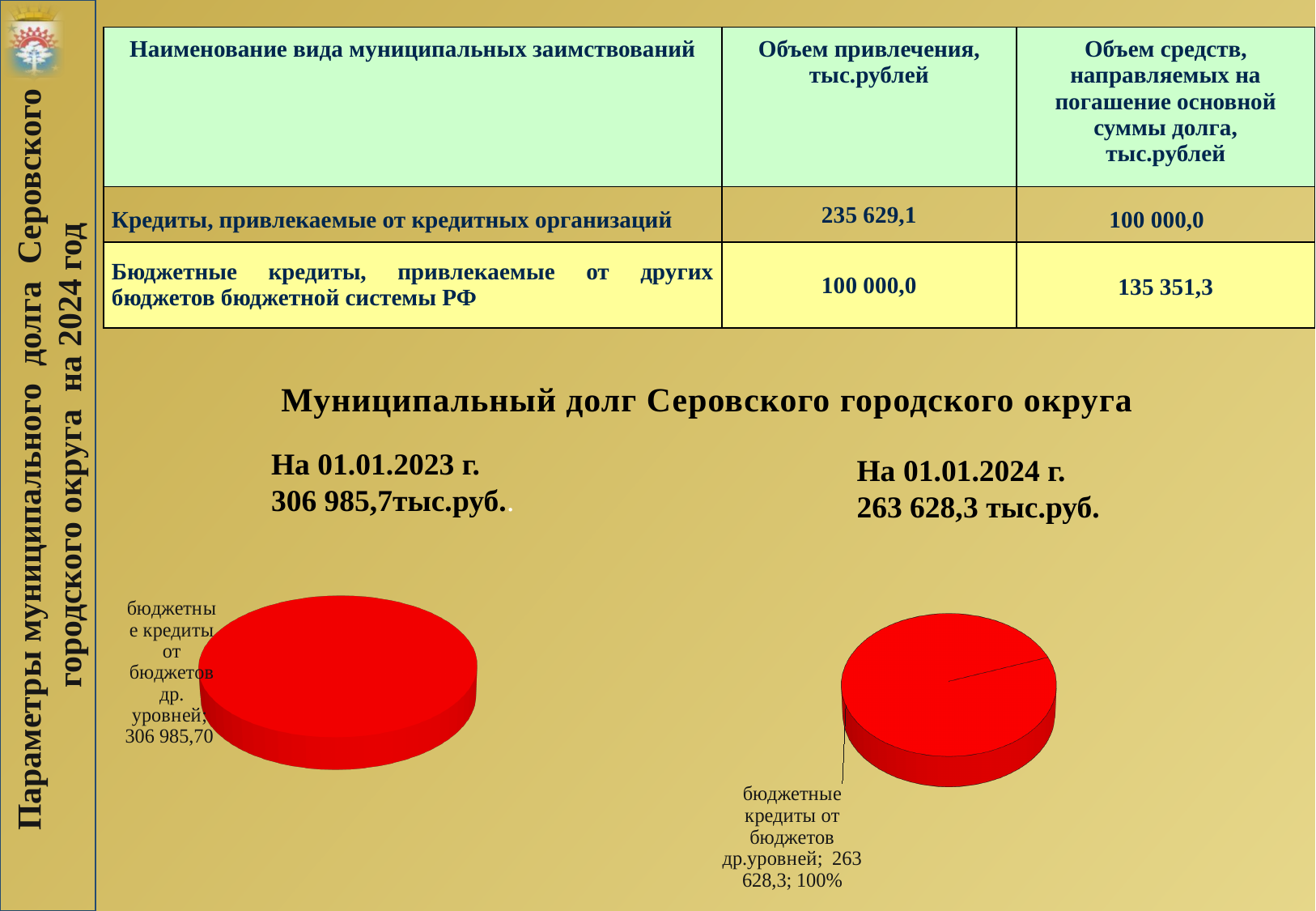
What colour are the slices in both pie charts? red What is the common title above the two pie charts? Муниципальный долг Серовского городского округа In the right pie chart (as of 01.01.2024), what share of the pie does бюджетные кредиты от бюджетов др.уровней represent? 100% Which is larger: the value in the left pie chart (01.01.2023) or the value in the right pie chart (01.01.2024)? the left pie chart (01.01.2023) What is the difference between the value in the left pie chart (306 985,70) and the value in the right pie chart (263 628,3)? 43 357,4 How many slices does the right pie chart (as of 01.01.2024) contain? 1 How many slices does the left pie chart (as of 01.01.2023) contain? 1 In the left pie chart (as of 01.01.2023), what value is shown for бюджетные кредиты от бюджетов др. уровней? 306 985,70 What kind of chart is used for the municipal debt as of 01.01.2024 (right chart)? pie chart What kind of chart is used for the municipal debt as of 01.01.2023 (left chart)? pie chart In the right pie chart (as of 01.01.2024), what value is shown for бюджетные кредиты от бюджетов др.уровней? 263 628,3